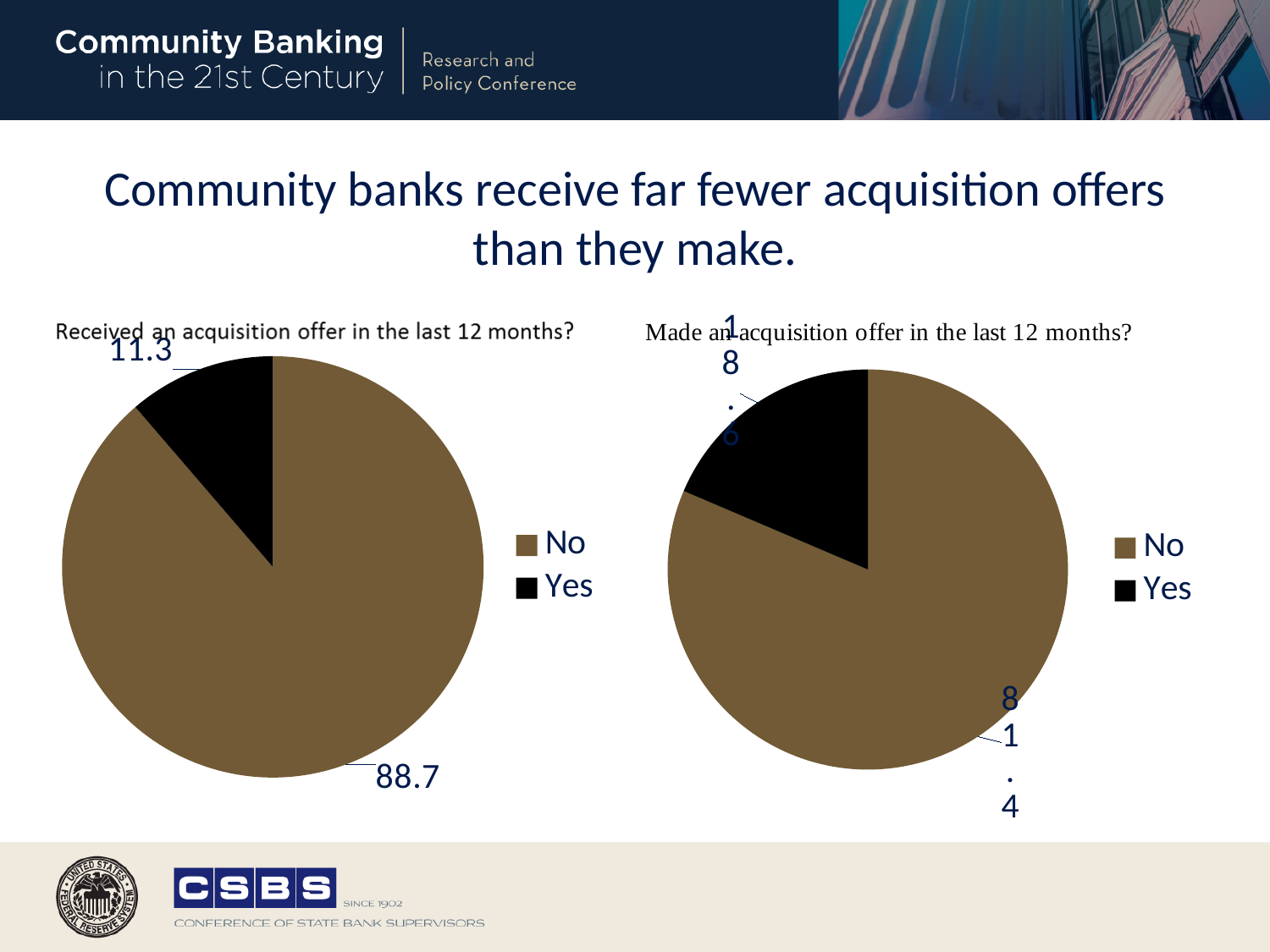
In the left chart, 'Received an acquisition offer in the last 12 months?', which response has the larger share? No In the left chart, 'Received an acquisition offer in the last 12 months?', what percentage of community banks answered Yes? 11.3 In the left chart, 'Received an acquisition offer in the last 12 months?', what colour is the Yes slice? Black How many slices does the left chart, 'Received an acquisition offer in the last 12 months?', have? 2 In the left chart, 'Received an acquisition offer in the last 12 months?', what percentage of community banks answered No? 88.7 Is the Yes share larger in the left chart (Received an acquisition offer) or the right chart (Made an acquisition offer)? Right chart (Made an acquisition offer) In the right chart, 'Made an acquisition offer in the last 12 months?', what value is shown for the Yes slice? 18.6 In the right chart, 'Made an acquisition offer in the last 12 months?', what value is shown for the No slice? 81.4 In the left chart, 'Received an acquisition offer in the last 12 months?', what is the difference between the No and Yes shares? 77.4 What type of chart is used on this slide? Pie chart How many entries does the legend of the right chart, 'Made an acquisition offer in the last 12 months?', list? 2 In the right chart, 'Made an acquisition offer in the last 12 months?', which response has the smaller share? Yes